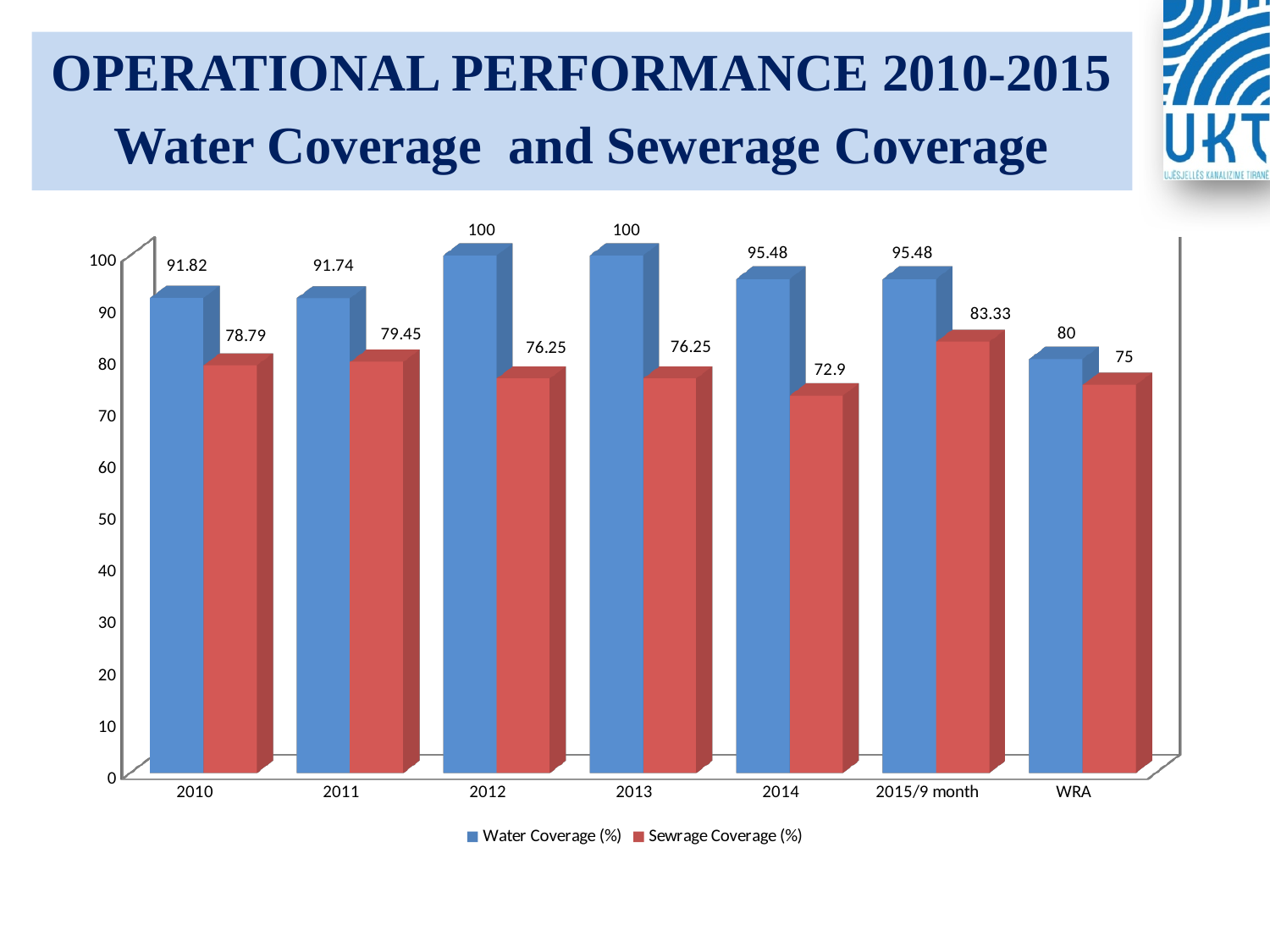
Which is larger, the Sewrage Coverage (%) value for 2011 or for 2010? 2011 What is the difference between Water Coverage (%) and Sewrage Coverage (%) in 2012? 23.75 Which colour represents Sewrage Coverage (%) in the chart? Red What is the Water Coverage (%) value for WRA? 80 Which category has the lowest Sewrage Coverage (%) value? 2014 How many categories are shown on the x axis? 7 Which category has the lowest Water Coverage (%) value? WRA What kind of chart is shown on the slide? Bar chart What is the Sewrage Coverage (%) value for 2015/9 month? 83.33 What is the Water Coverage (%) value for 2010? 91.82 What is the Sewrage Coverage (%) value for 2014? 72.9 How many series does the legend list? 2